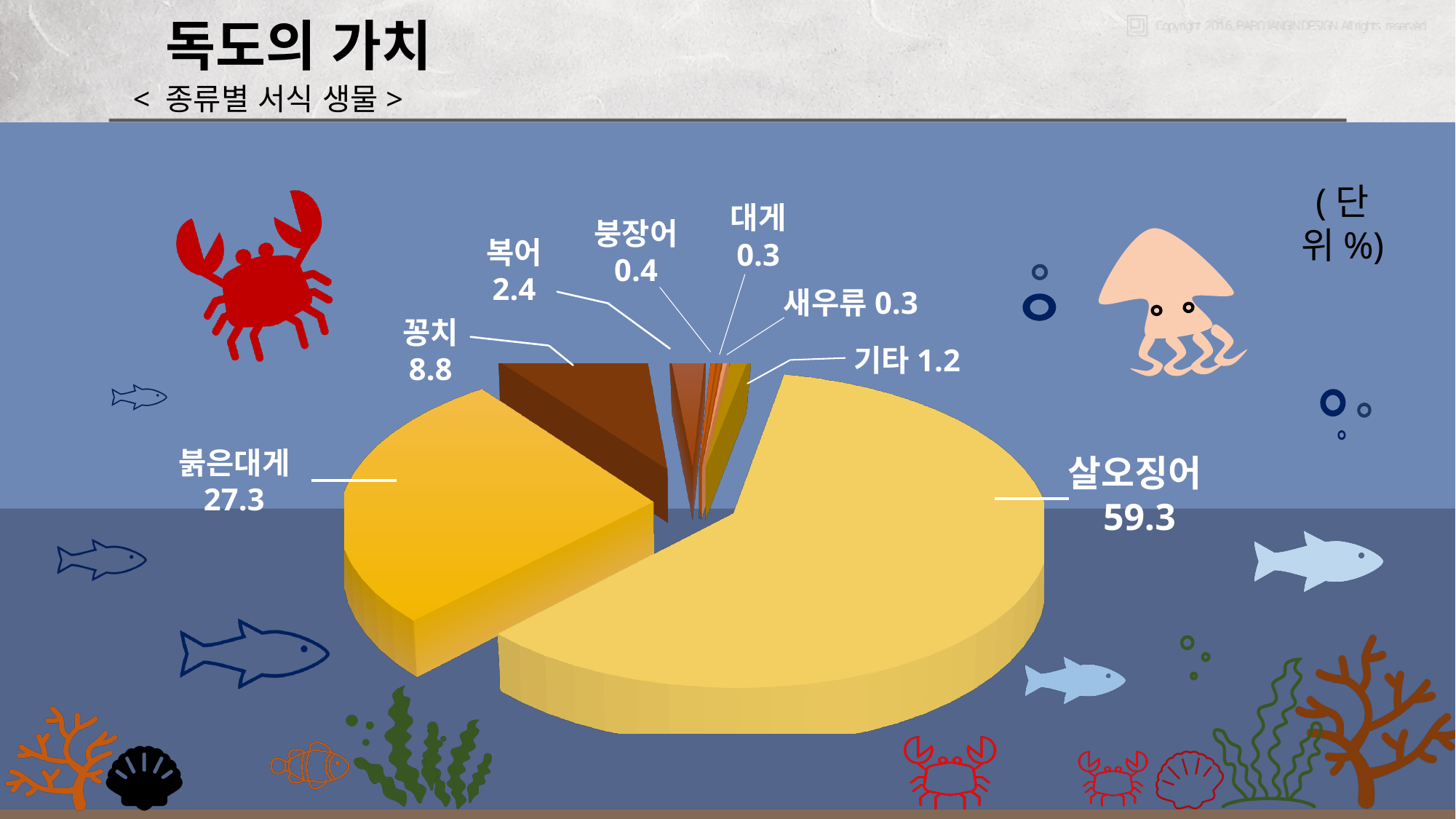
What unit is indicated for the values in the chart? % What kind of chart is shown on the slide? pie chart What share of the pie does 붕장어 represent, in percent? 0.4 What is the difference between the values for 살오징어 and 붉은대게? 32.0 How many categories are shown in the pie chart? 8 What is the value for 복어? 2.4 What is the value for 살오징어? 59.3 What is the value for 꽁치? 8.8 Which is larger, the value for 꽁치 or the value for 복어? 꽁치 What is the value for 붉은대게? 27.3 Which category has the largest slice of the pie? 살오징어 What is the value for 기타? 1.2